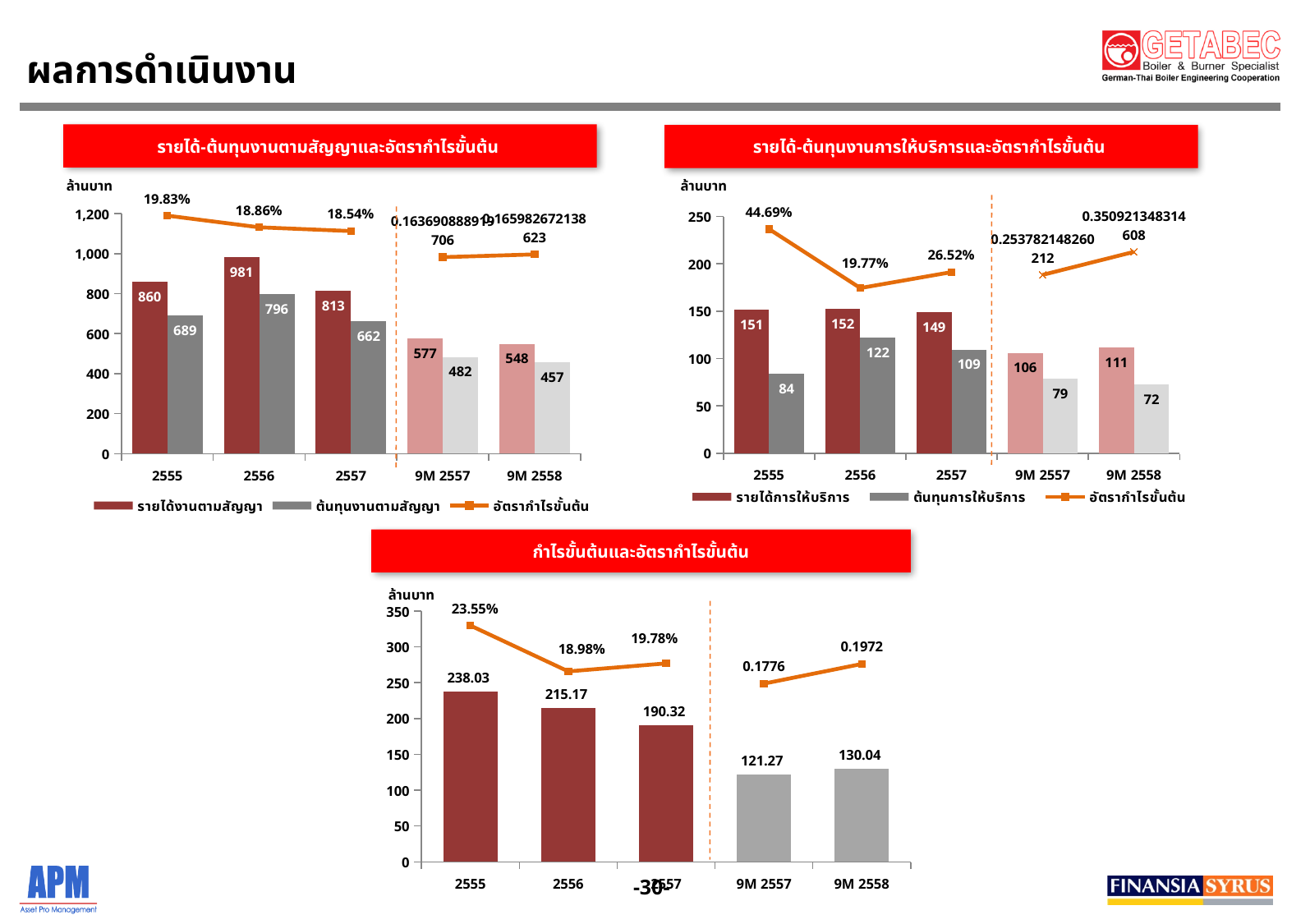
In the bottom chart, do the gross profit bars rise or fall from 2555 to 2557? fall In the top-right chart, what gross margin percentage is shown for 2555? 44.69% In the top-right chart, what is the service revenue (dark red bar) for 2557? 149 In the bottom chart, what is the gross profit value for 2555? 238.03 How many entries does the legend of the top-left chart list? 3 In the top-left chart, which year among 2555, 2556 and 2557 has the highest contract revenue? 2556 In the top-right chart, is the service revenue for 9M 2557 larger or smaller than the service cost for 9M 2557? larger In the top-left chart, what is the contract revenue (dark red bar) for 2556? 981 In the top-right chart, which category has the lowest service cost (gray bar)? 9M 2558 In the top-left chart, what is the contract cost (gray bar) for 9M 2558? 457 In the top-left chart, what gross margin percentage is shown for 2555? 19.83% In the top-left chart, what is the difference between contract revenue and contract cost in 2555? 171